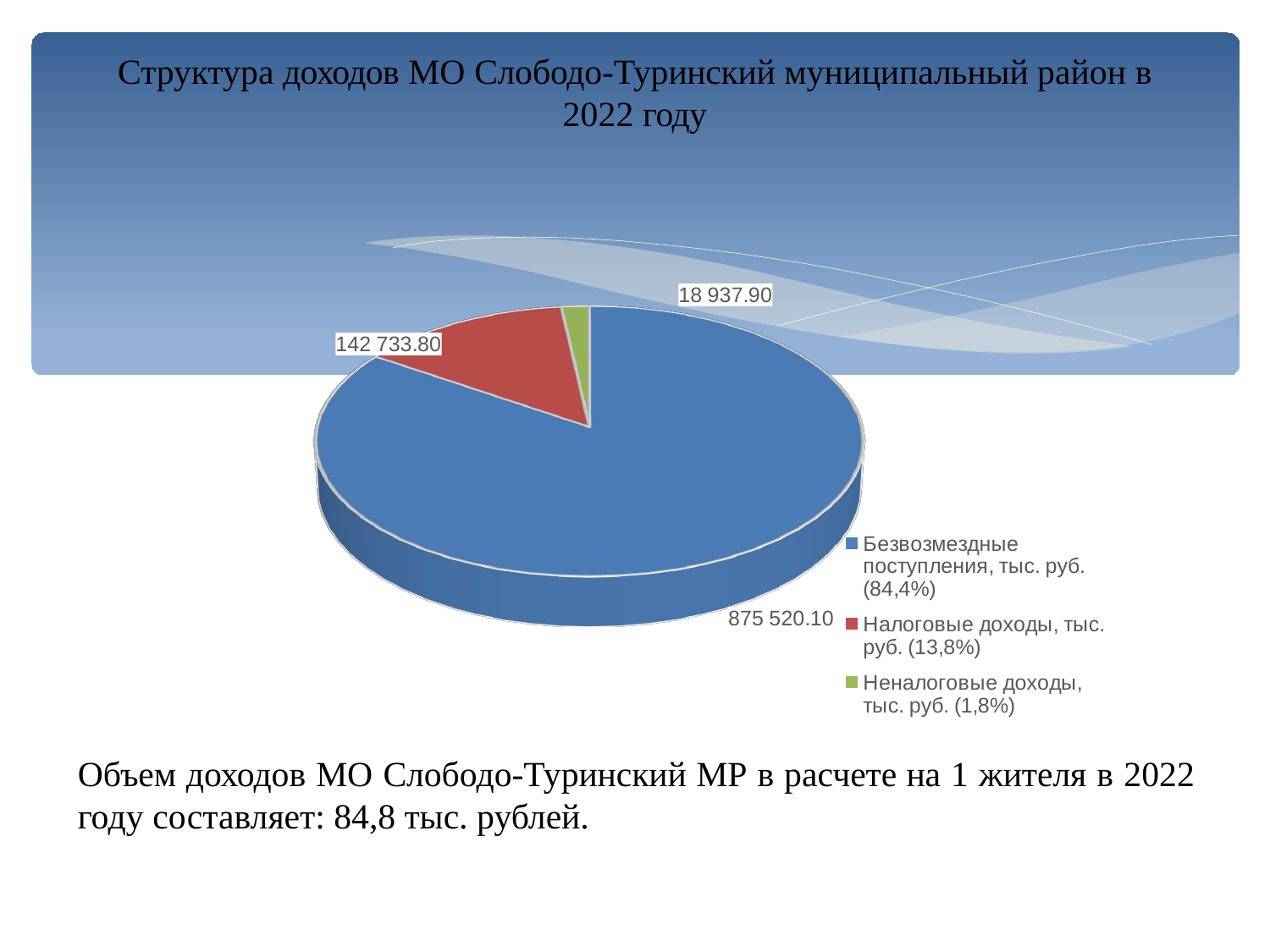
Which is larger, Налоговые доходы or Неналоговые доходы? Налоговые доходы What is the difference between the values for Налоговые доходы and Неналоговые доходы? 123 795.90 What is the value for Налоговые доходы? 142 733.80 What is the value for Неналоговые доходы? 18 937.90 Which category has the largest slice of the pie? Безвозмездные поступления What colour is the slice for Неналоговые доходы? Green Which category has the smallest slice of the pie? Неналоговые доходы What kind of chart is shown on the slide? Pie chart What share of the pie does Налоговые доходы represent, according to the legend? 13,8% What is the value for Безвозмездные поступления? 875 520.10 How many slices does the pie chart have? 3 What is the difference between the values for Безвозмездные поступления and Налоговые доходы? 732 786.30